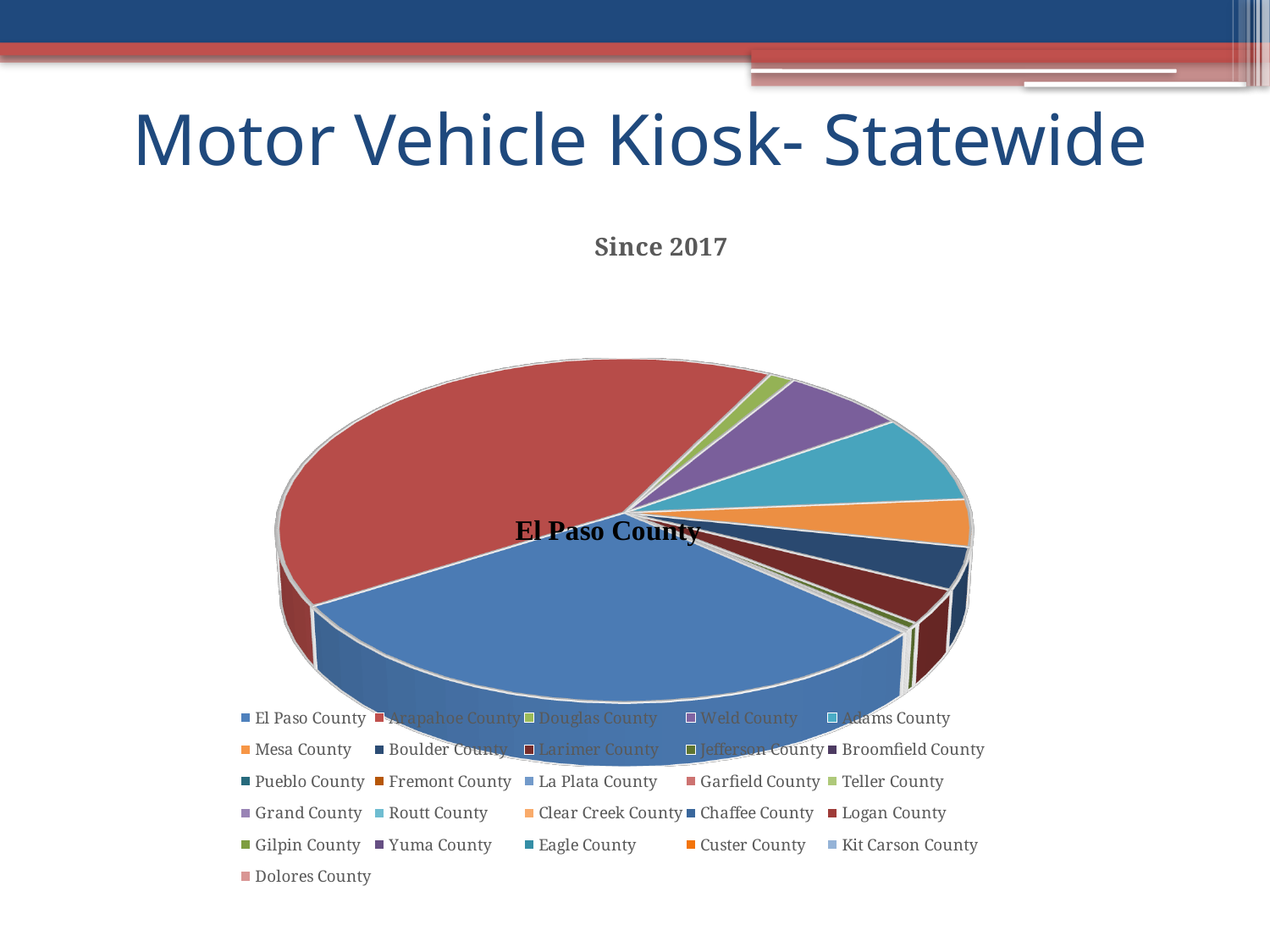
Which slice is larger, Adams County or Mesa County? Adams County Which county's slice is labeled directly on the pie? El Paso County Which slice is larger, Arapahoe County or Mesa County? Arapahoe County What kind of chart is shown on the slide? Pie chart Which slice is larger, Arapahoe County or Weld County? Arapahoe County How many counties does the chart's legend list? 26 What is the title of the chart? Since 2017